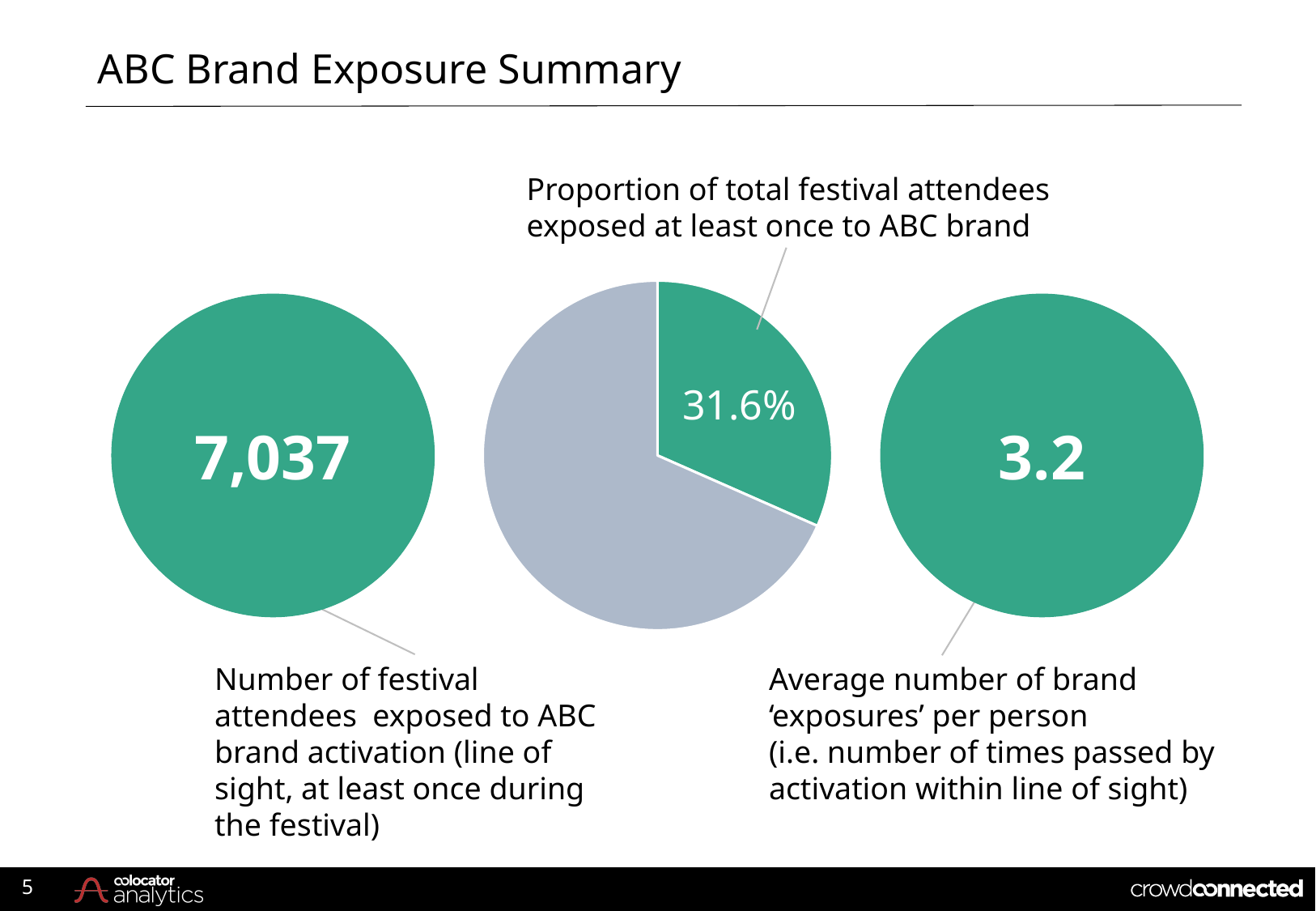
What kind of chart is shown in the middle of the slide? pie chart Is the green slice of the pie chart greater or less than 50% of the pie? less Which slice of the pie chart is the smallest? the green slice (31.6%) How many slices does the pie chart have? 2 What colour is the slice labelled 31.6% in the pie chart? green In the pie chart, which slice is larger, the green slice or the grey slice? the grey slice What does the pie chart show, according to its label? Proportion of total festival attendees exposed at least once to ABC brand In the pie chart, what share of total festival attendees were exposed at least once to ABC brand? 31.6%